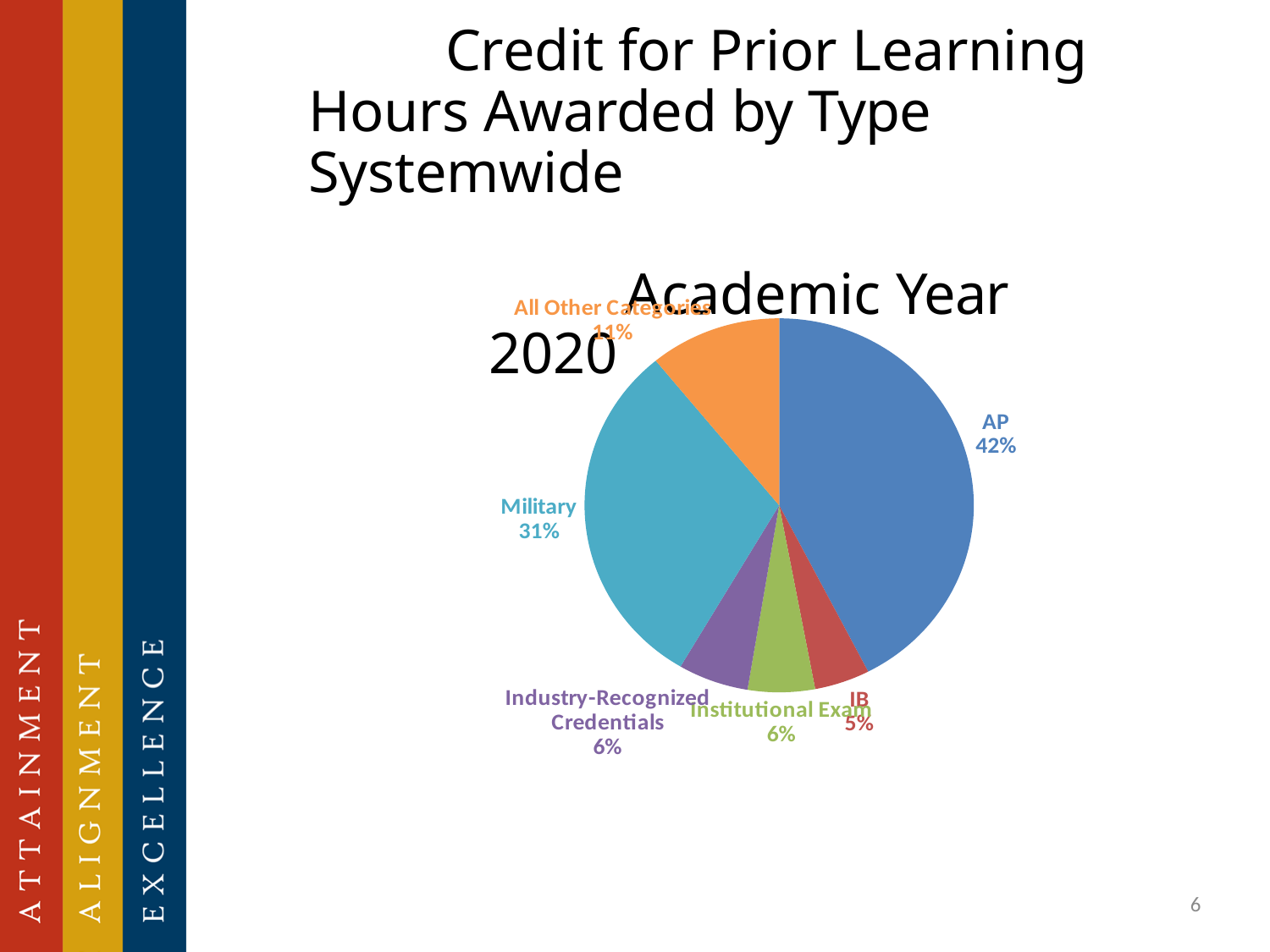
What is the difference in percentage points between AP and Military? 11 What percentage is shown for All Other Categories? 11% Which is larger, the share for Military or the share for All Other Categories? Military What percentage is shown for Industry-Recognized Credentials? 6% What percentage is shown for IB? 5% Which category has the largest share of the pie? AP What is the title of the chart? Academic Year 2020 How many categories are shown in the pie chart? 6 Which category has the smallest share of the pie? IB What share of the pie does AP represent? 42% What type of chart is shown on the slide? Pie chart What percentage is shown for Military? 31%